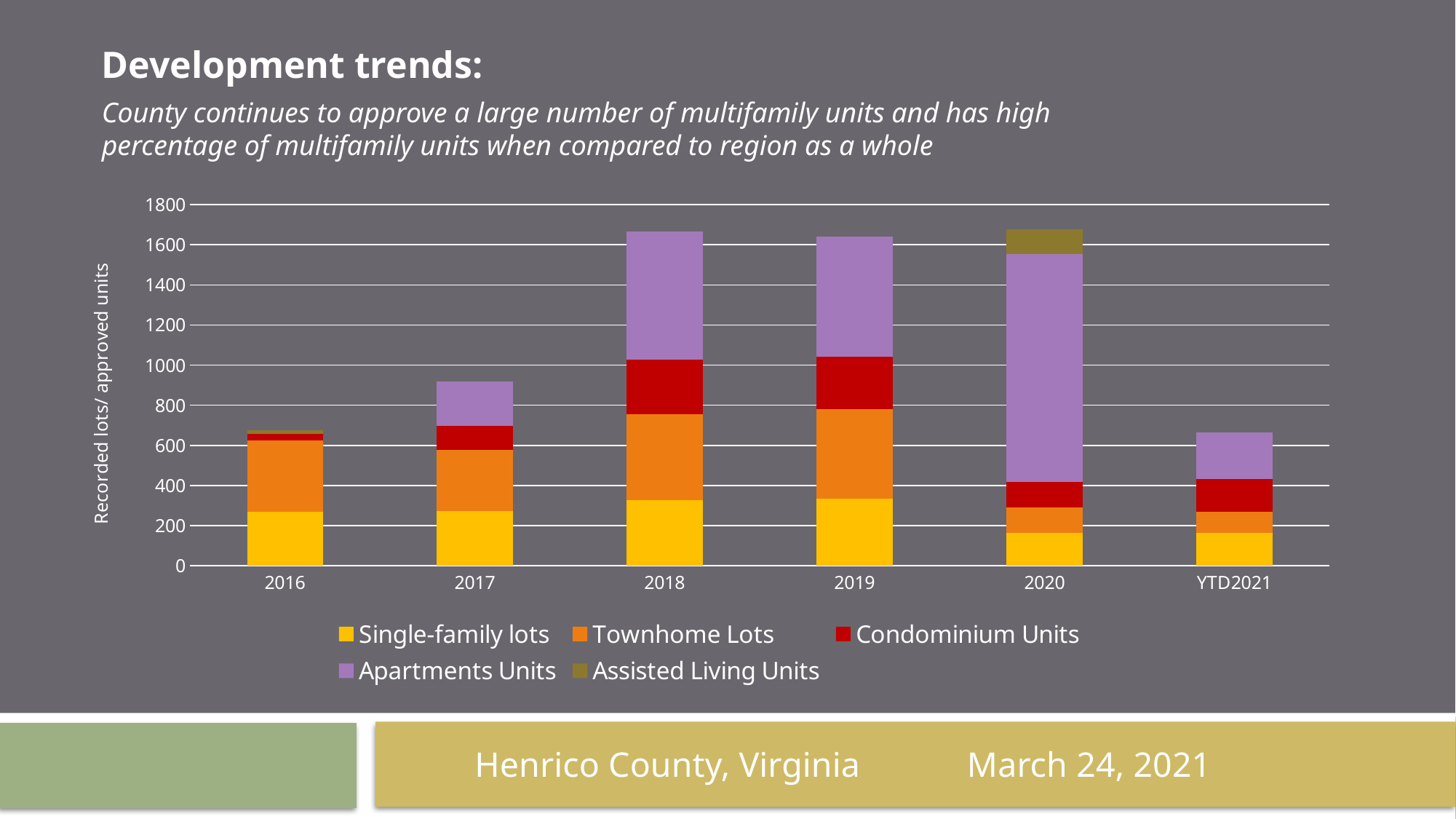
Is the total stacked value for 2016 greater or less than 600? greater Which year has the larger total stacked value, 2017 or 2018? 2018 Which has the larger total stacked value, 2019 or YTD2021? 2019 How many series does the legend list? 5 Which year has the largest Apartments Units segment? 2020 What kind of chart is shown on the slide? Stacked bar chart Is the total stacked value for 2018 greater or less than 1600? greater What is the label on the vertical axis? Recorded lots/ approved units Is the total stacked value for 2017 greater or less than 1000? less Which year has the larger Single-family lots segment, 2019 or 2020? 2019 How many year categories are shown on the x axis? 6